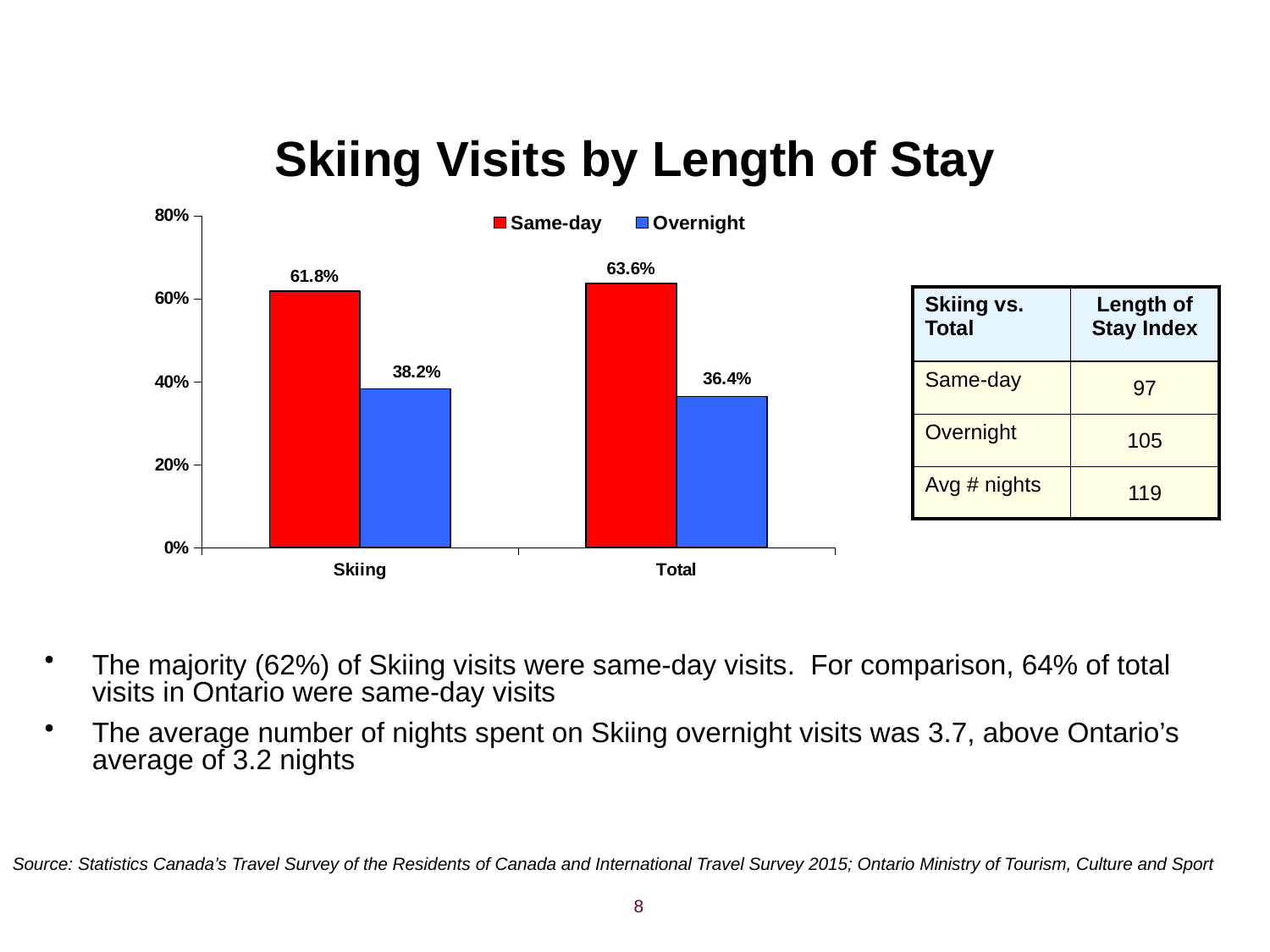
How many categories are shown on the x axis? 2 What kind of chart is shown on the slide? Bar chart What is the Same-day value for Total? 63.6% What is the Overnight value for Total? 36.4% What colour are the Overnight bars? Blue What is the difference between the Same-day and Overnight values for Skiing? 23.6% Which category has the higher Same-day value, Skiing or Total? Total What is the difference between the Same-day values for Total and Skiing? 1.8% How many series does the legend list? 2 What is the Same-day value for Skiing? 61.8% Which category has the higher Overnight value, Skiing or Total? Skiing What is the Overnight value for Skiing? 38.2%